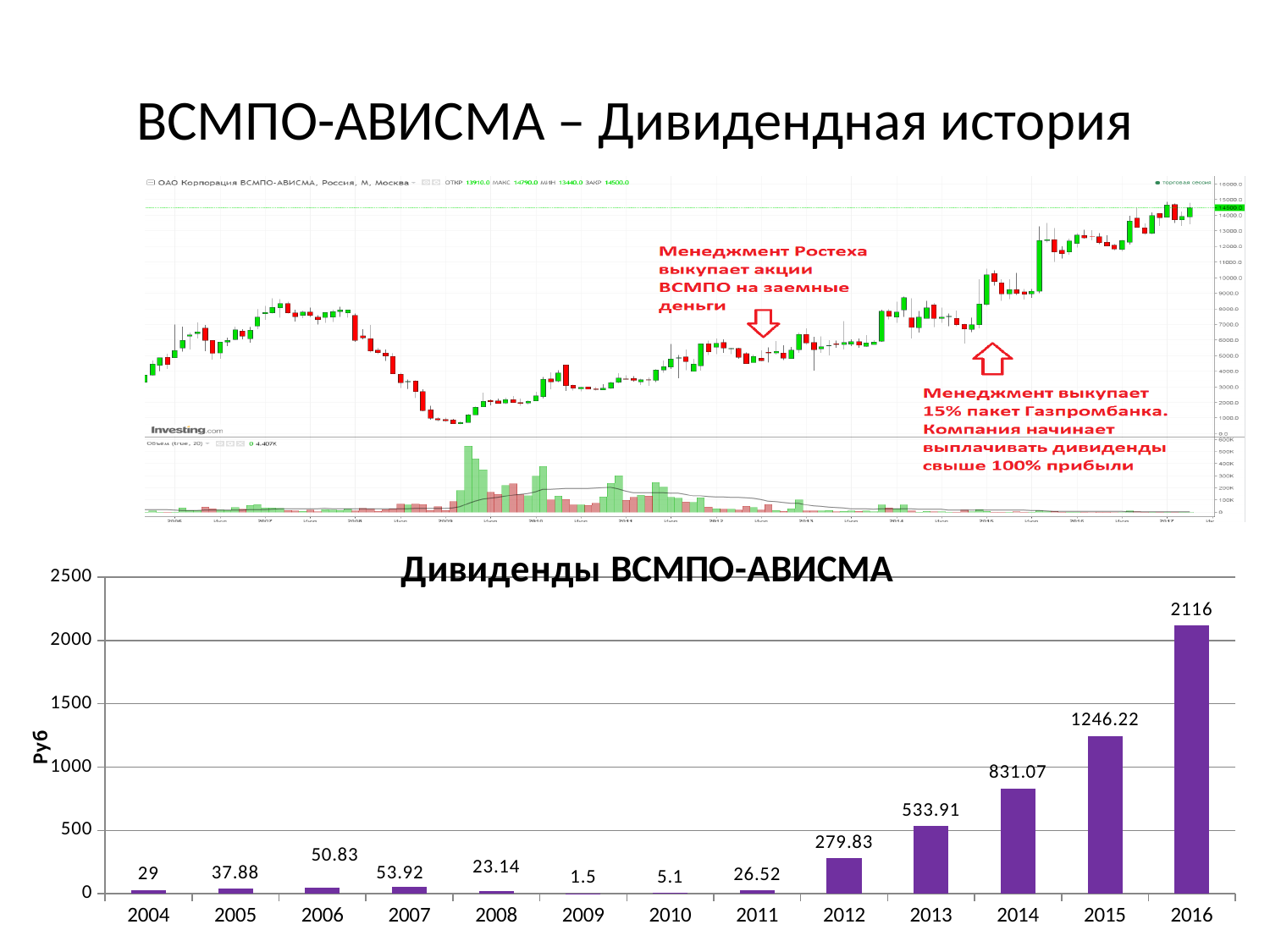
In the chart titled "Дивиденды ВСМПО-АВИСМА", what is the difference between the dividend for 2013 and the dividend for 2012? 254.08 In the chart titled "Дивиденды ВСМПО-АВИСМА", what is the dividend value for 2012? 279.83 In the chart titled "Дивиденды ВСМПО-АВИСМА", which year has the lowest dividend? 2009 In the chart titled "Дивиденды ВСМПО-АВИСМА", which year has a larger dividend, 2007 or 2008? 2007 How many years are shown on the x axis of the chart titled "Дивиденды ВСМПО-АВИСМА"? 13 In the chart titled "Дивиденды ВСМПО-АВИСМА", what is the label on the vertical axis? Руб In the chart titled "Дивиденды ВСМПО-АВИСМА", what is the dividend value for 2009? 1.5 In the chart titled "Дивиденды ВСМПО-АВИСМА", what is the dividend value for 2016? 2116 What kind of chart is the chart titled "Дивиденды ВСМПО-АВИСМА"? bar chart In the chart titled "Дивиденды ВСМПО-АВИСМА", which year has the highest dividend? 2016 In the chart titled "Дивиденды ВСМПО-АВИСМА", what is the difference between the dividend for 2016 and the dividend for 2015? 869.78 In the chart titled "Дивиденды ВСМПО-АВИСМА", is the value for 2014 greater or less than 1000? less